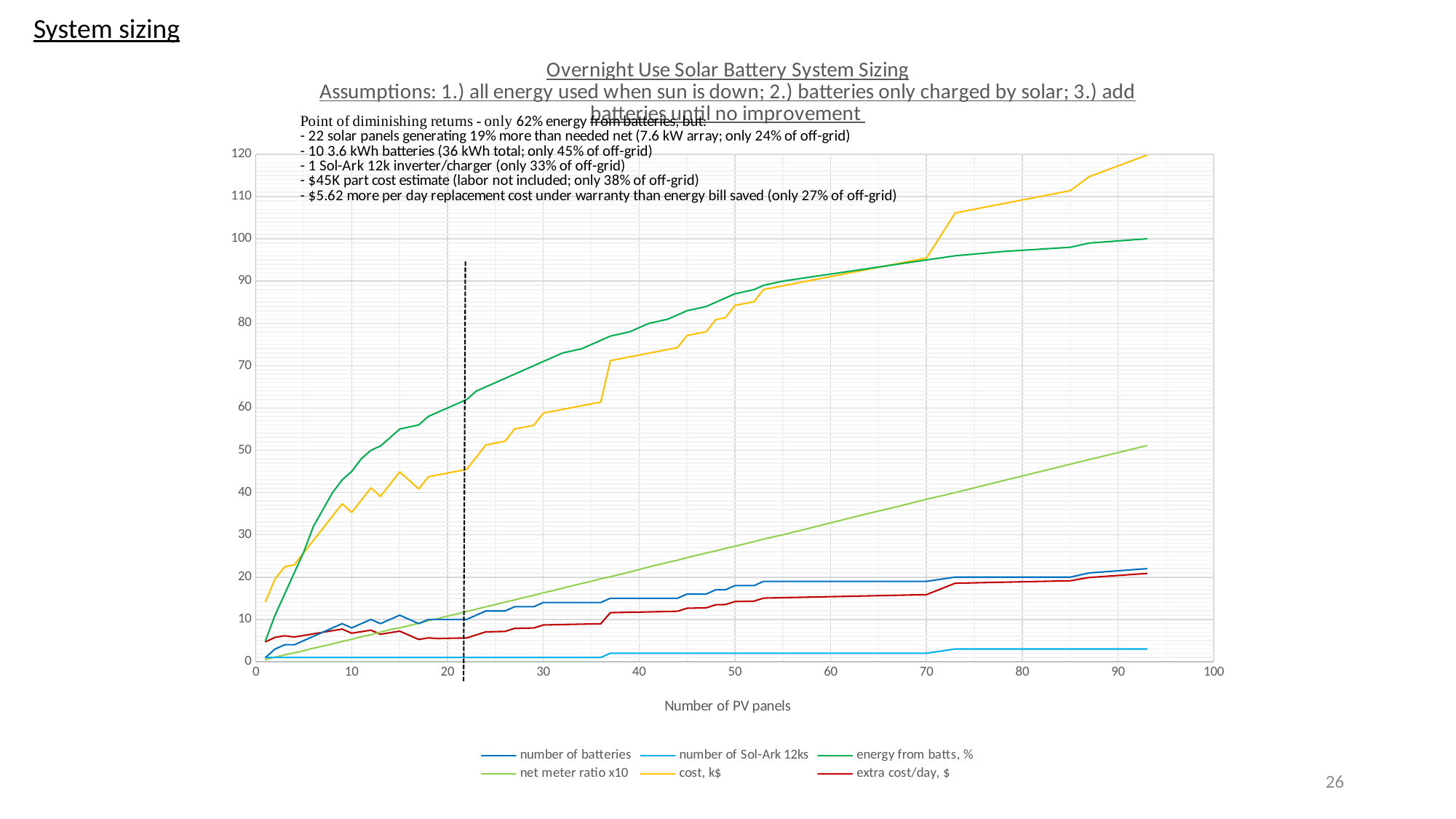
What kind of chart is shown on the slide? line chart Which series is drawn in yellow in the chart? cost, k$ What is the title of the x axis of the chart? Number of PV panels Is the value of 'energy from batts, %' at 10 PV panels greater or less than 30? greater Is the value of 'number of Sol-Ark 12ks' at 50 PV panels greater or less than 10? less Is the value of 'net meter ratio x10' at 80 PV panels greater or less than 50? less How many series does the chart legend list? 6 At 90 PV panels, which series has the larger value: 'net meter ratio x10' or 'number of batteries'? net meter ratio x10 Does the 'cost, k$' series rise or fall as the number of PV panels increases? rise Does the 'energy from batts, %' series rise or fall as the number of PV panels increases? rise At 30 PV panels, which series has the larger value: 'energy from batts, %' or 'cost, k$'? energy from batts, %